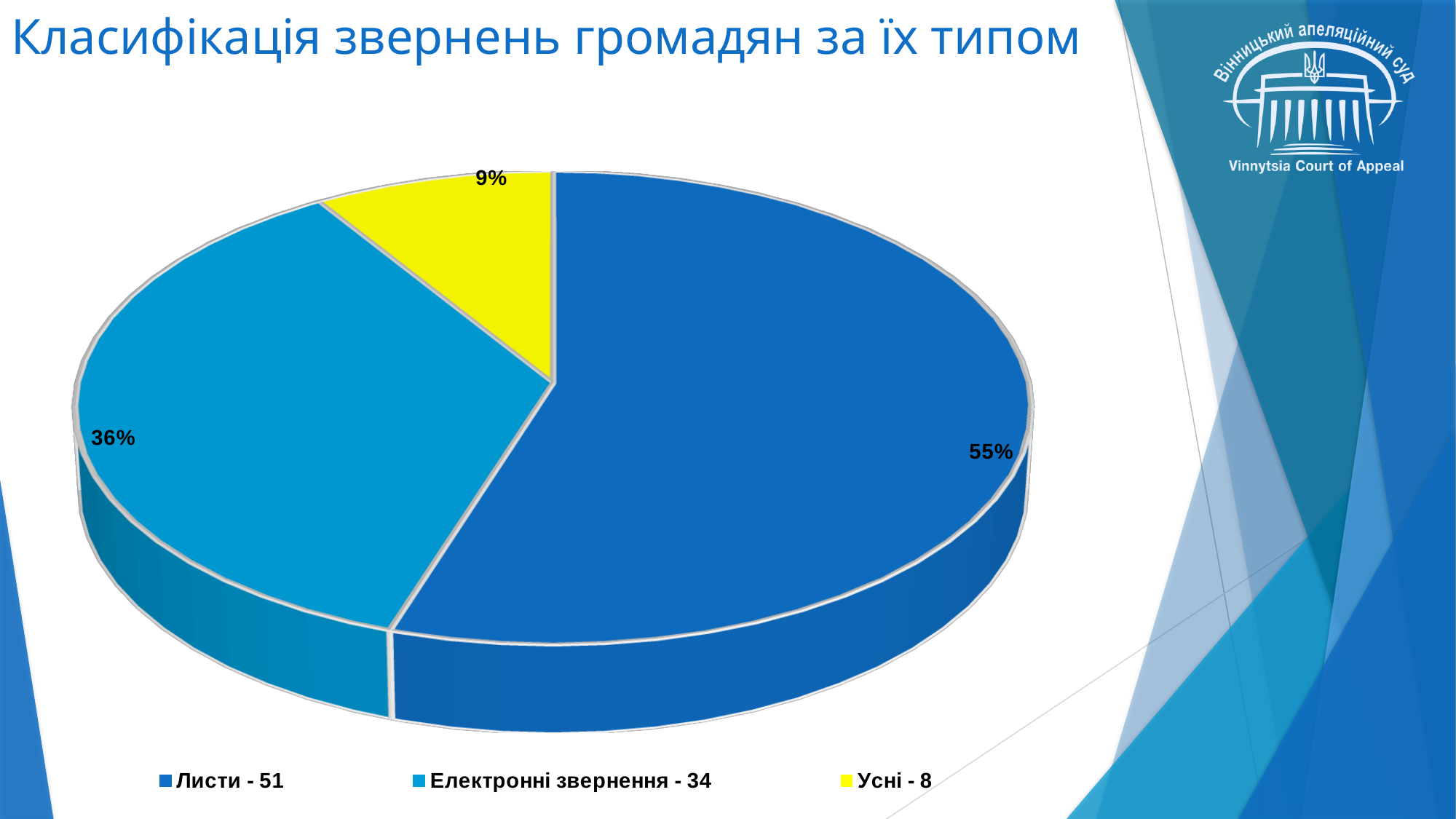
What percentage share does the "Листи - 51" slice have? 55% How many slices does the pie chart have? 3 Which category has the largest slice of the pie? Листи - 51 Which category has the smallest slice of the pie? Усні - 8 What percentage share does the "Електронні звернення - 34" slice have? 36% What colour is the "Усні - 8" slice? yellow What percentage share does the "Усні - 8" slice have? 9% How many entries does the legend list? 3 What is the title of the chart on the slide? Класифікація звернень громадян за їх типом What kind of chart is shown on the slide? pie chart Which slice is larger: "Електронні звернення - 34" or "Усні - 8"? Електронні звернення - 34 What is the difference in percentage points between the "Листи - 51" slice and the "Електронні звернення - 34" slice? 19